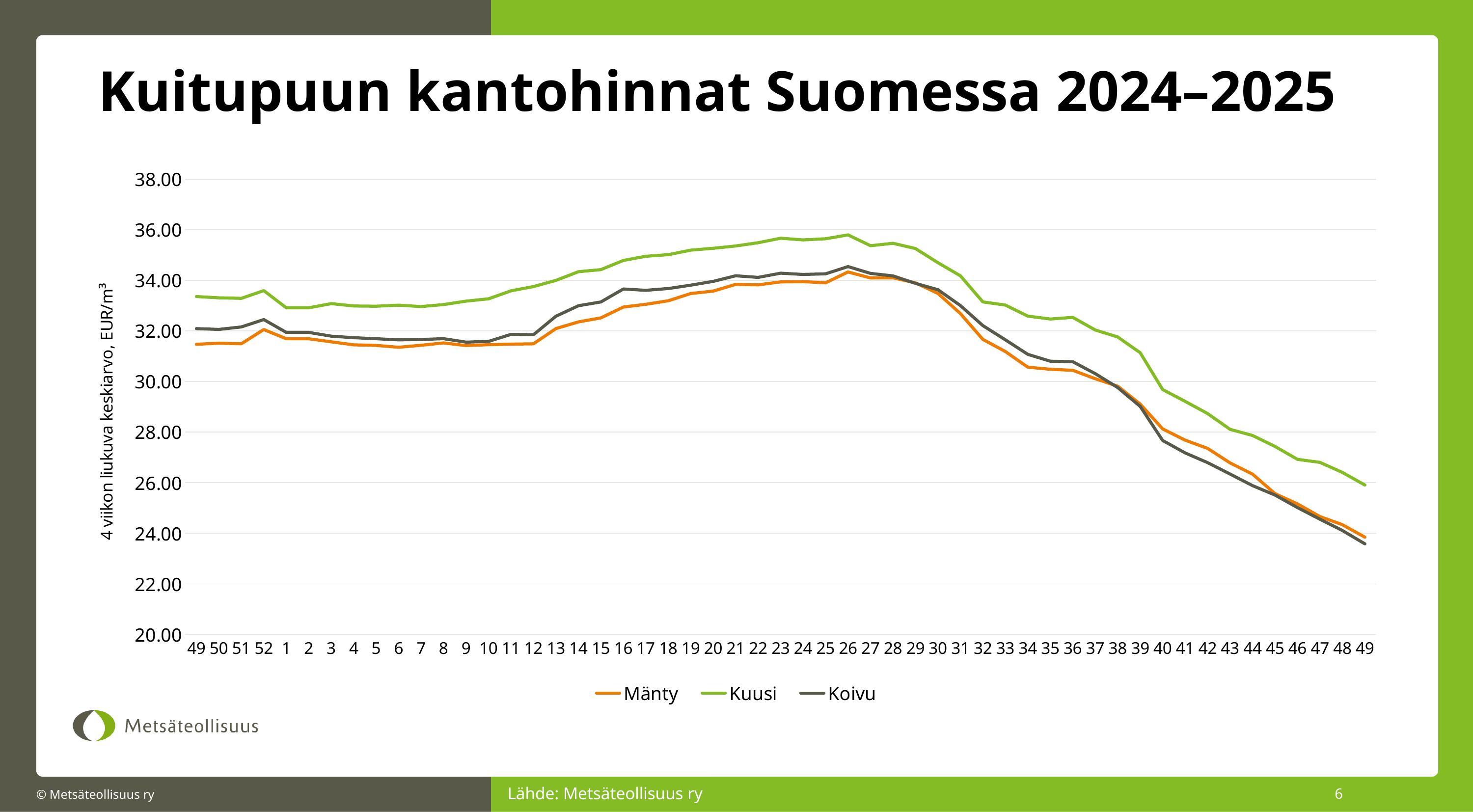
Which series are listed in the legend? Mänty, Kuusi, Koivu What is the title of the chart on the slide? Kuitupuun kantohinnat Suomessa 2024–2025 Is the value for Mänty at week 40 greater or less than 30.00? less Which series has the lowest value at week 16? Mänty Is the value for Kuusi at week 26 greater or less than 34.00? greater Is the value for Mänty at the final week 49 greater or less than 26.00? less Do the values for Kuusi rise or fall from week 30 to the final week 49? fall At the first week 49, which is larger, the value for Koivu or the value for Mänty? Koivu How many series does the legend list? 3 Which series has the highest value at week 26? Kuusi What kind of chart is shown on the slide? line chart